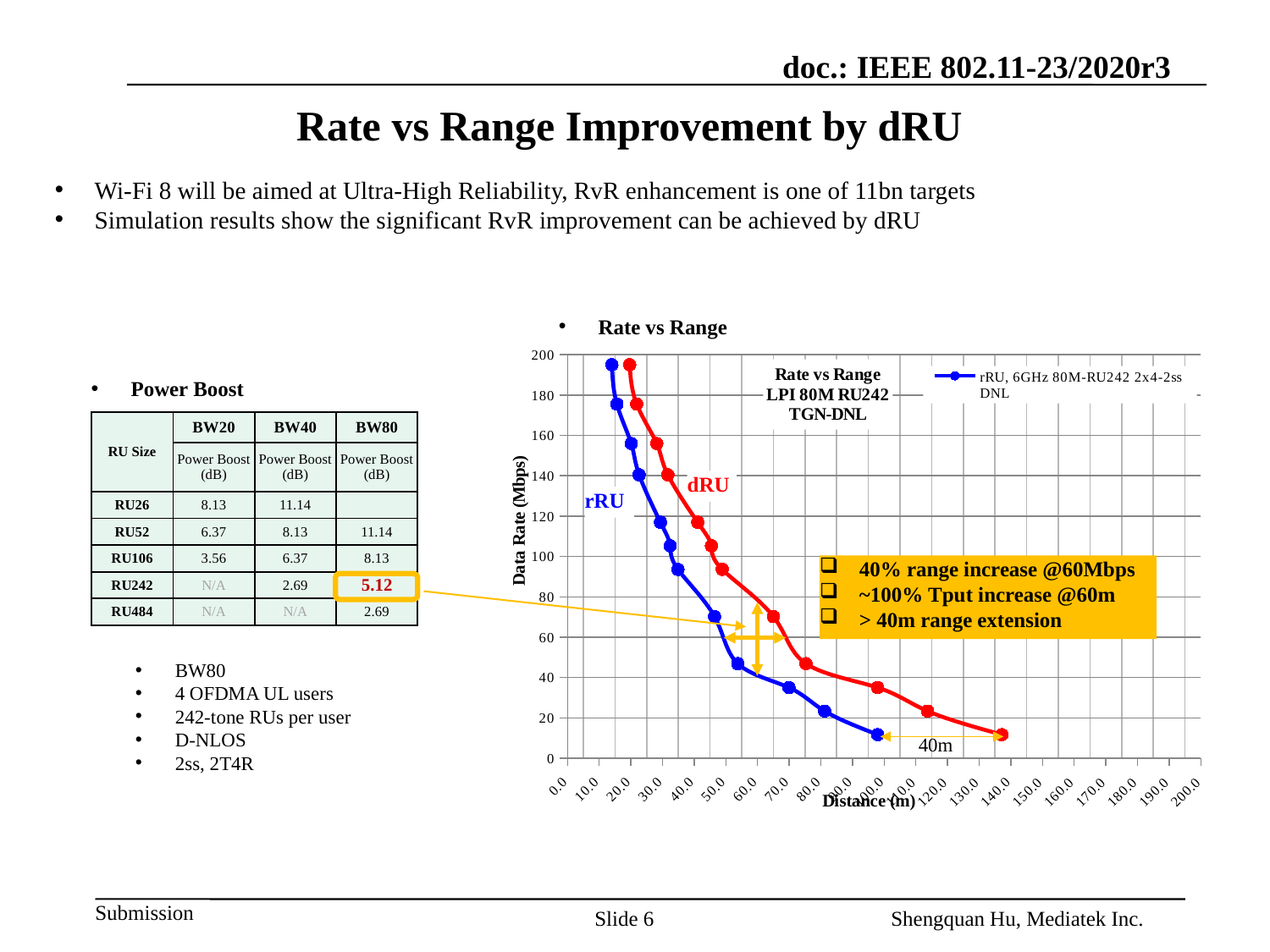
In the Rate vs Range chart, what colour is the rRU line? Blue In the Rate vs Range chart, is the data rate of the first rRU point (at the shortest distance) greater or less than 180 Mbps? greater In the Rate vs Range chart, which series reaches the farther distance, rRU or dRU? dRU What is the title shown inside the chart? Rate vs Range LPI 80M RU242 TGN-DNL In the Rate vs Range chart, which series has the higher data rate at a distance of 60 m, rRU or dRU? dRU What kind of chart is shown on the slide? Line chart In the Rate vs Range chart, is the distance of the farthest rRU point greater or less than 120 m? less In the Rate vs Range chart, is the data rate of the last rRU point (at the farthest distance) greater or less than 20 Mbps? less In the Rate vs Range chart, does the data rate rise or fall as distance increases? Fall